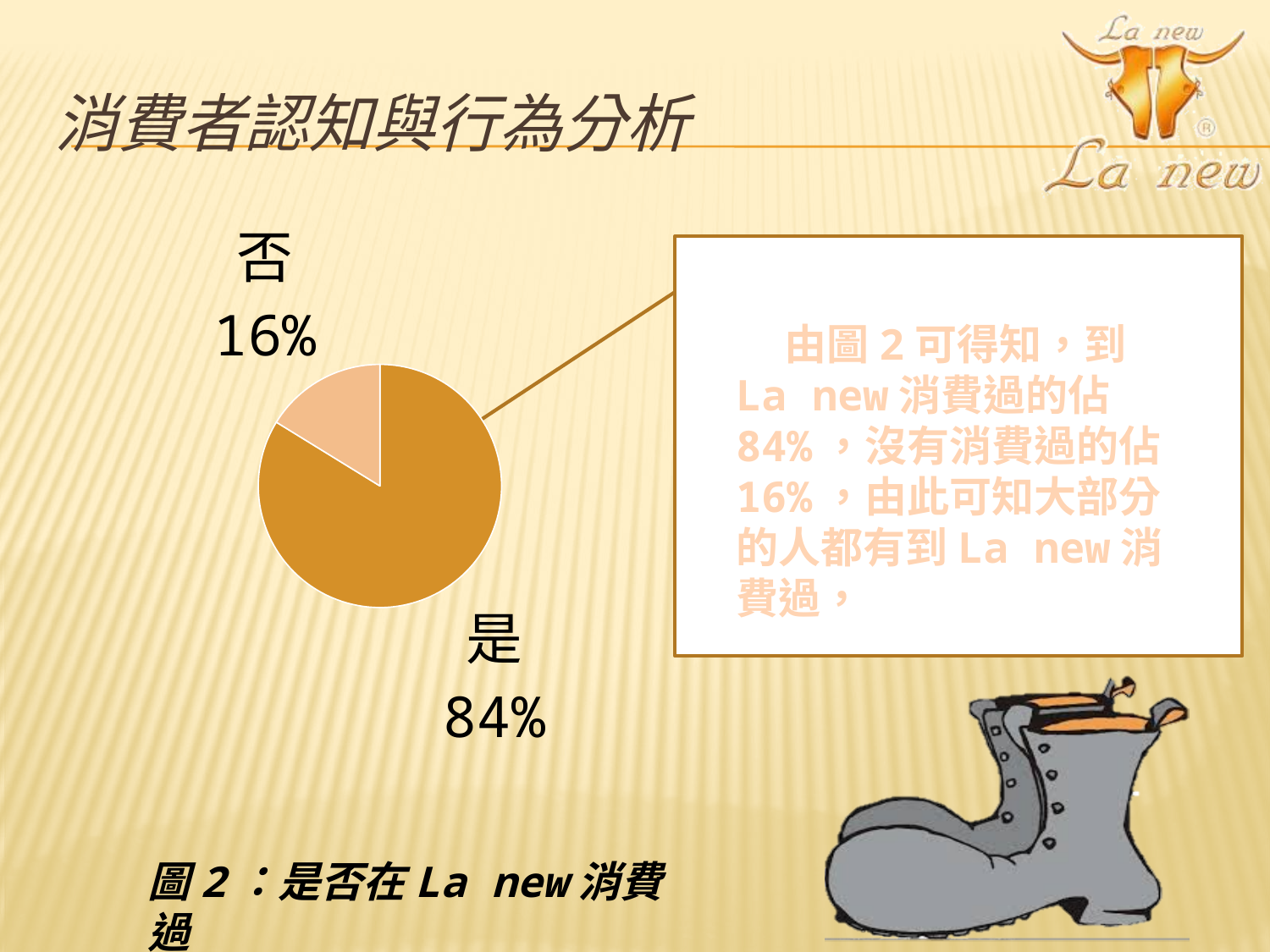
What share of the pie does 是 (yes) take? 84% Is the share for 是 greater or less than 50%? greater What is the difference in percentage points between the 是 slice and the 否 slice? 68% What is the caption of the chart shown below the pie? 圖 2：是否在 La new 消費過 Which slice of the pie is the smallest? 否 Which slice of the pie is the largest? 是 What share of the pie does 否 (no) take? 16% How many slices does the pie chart have? 2 What kind of chart is shown on the slide? pie chart Which is larger, the 是 slice or the 否 slice? 是 What is the total of the two pie slices' percentages? 100%